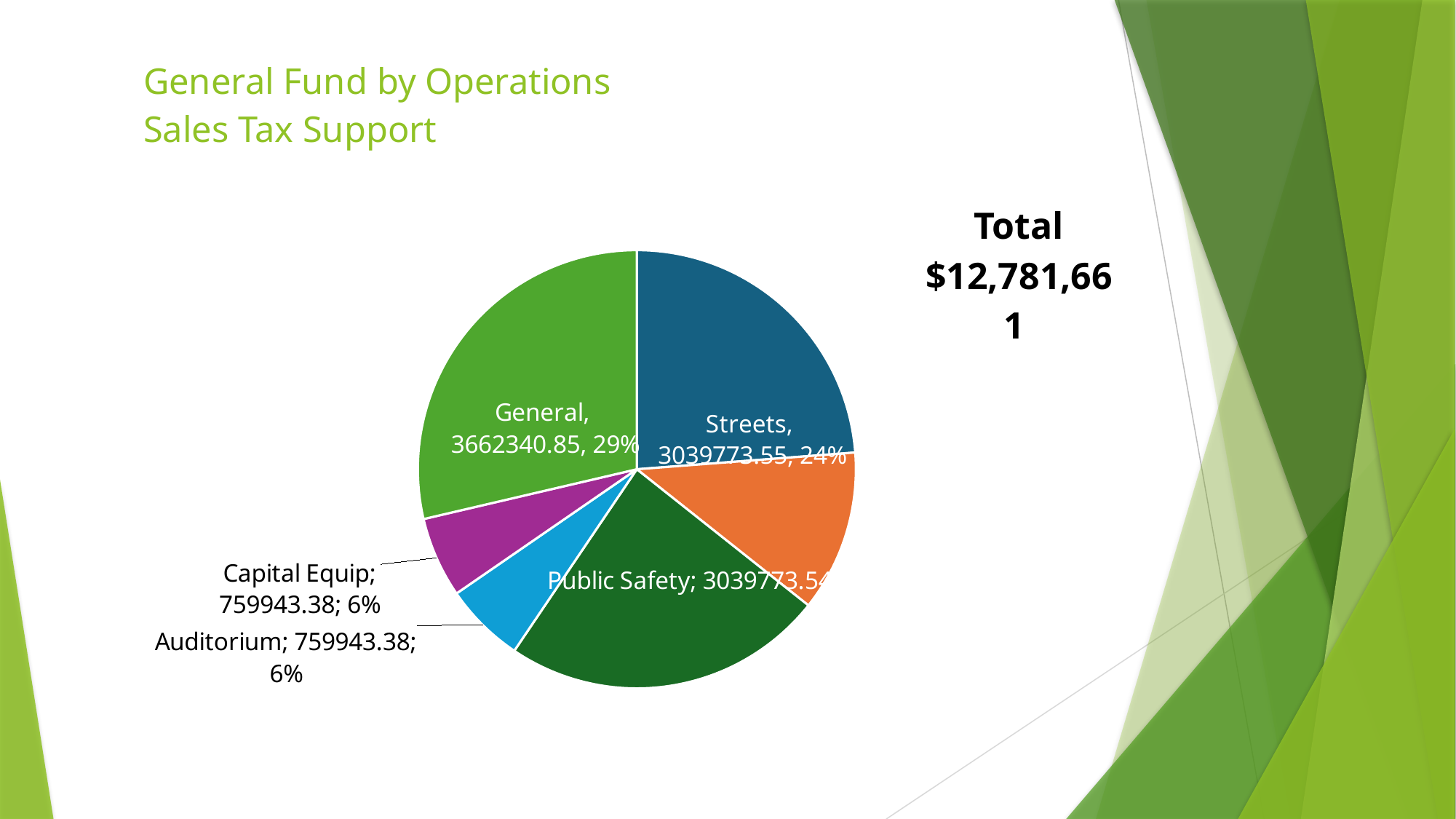
What is the value shown for the General slice? 3662340.85 What is the value shown for Capital Equip? 759943.38 What total amount is printed next to the pie chart? $12,781,661 What is the value shown for Public Safety? 3039773.54 What percentage share does the Streets slice have? 24% What kind of chart is shown on the slide? pie chart What percentage share does the General slice have? 29% What is the difference between the General value and the Streets value? 622567.30 Which labelled category has the largest slice of the pie? General Which is larger, the General slice or the Streets slice? General What percentage share does the Auditorium slice have? 6% How many slices does the pie chart have? 6